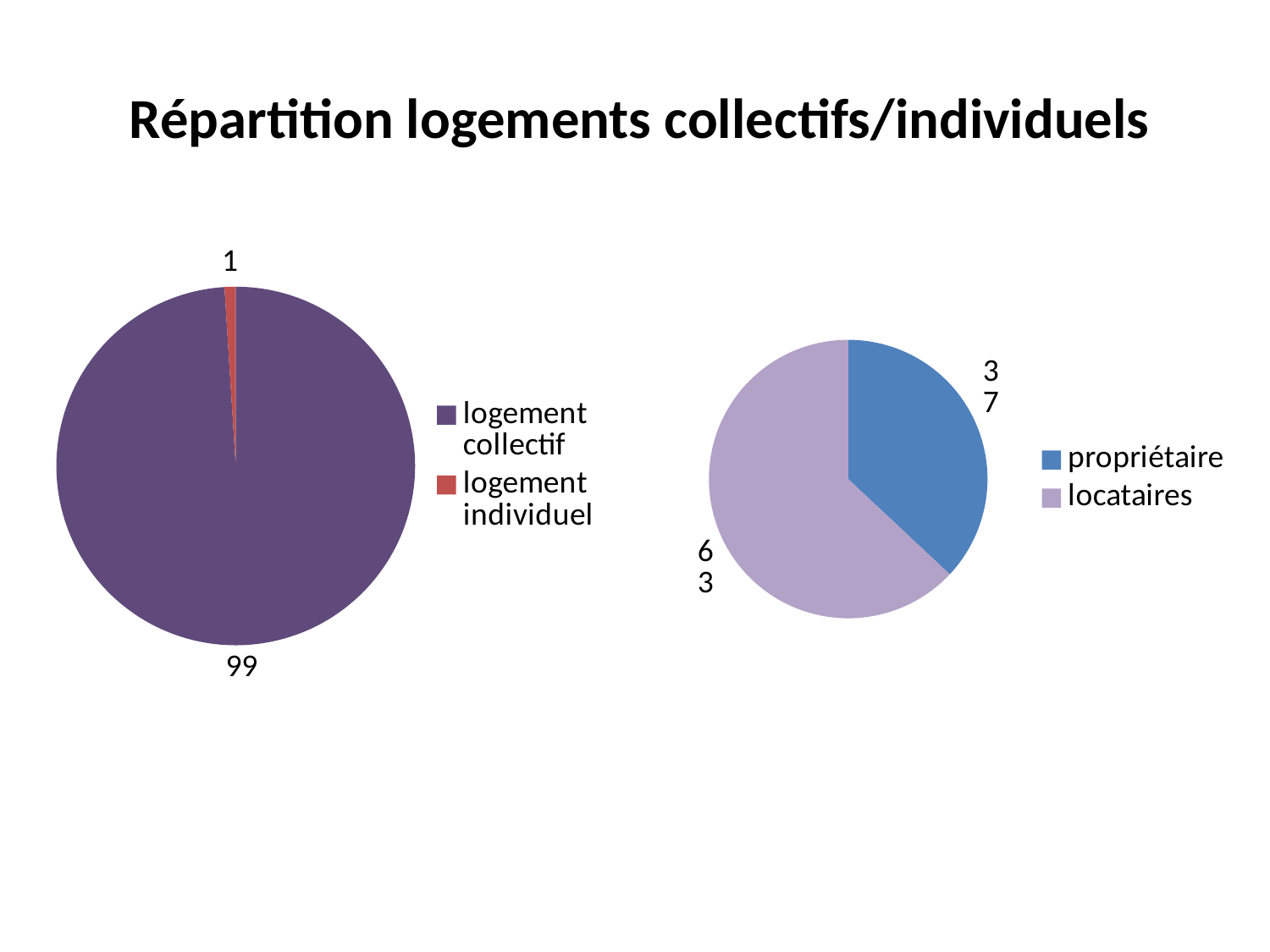
On the right pie chart, which category has the larger slice, propriétaire or locataires? locataires On the right pie chart, how many entries does the legend list? 2 What kind of chart is the chart on the left of the slide? pie chart On the right pie chart, what is the difference between the values for locataires and propriétaire? 26 On the right pie chart, what is the value for propriétaire? 37 On the right pie chart, what is the value for locataires? 63 On the left pie chart, what is the value for logement collectif? 99 On the left pie chart, which category has the smallest slice? logement individuel On the left pie chart, how many categories are shown? 2 On the left pie chart, which category has the largest slice? logement collectif On the left pie chart, what is the value for logement individuel? 1 On the left pie chart, what is the difference between the values for logement collectif and logement individuel? 98